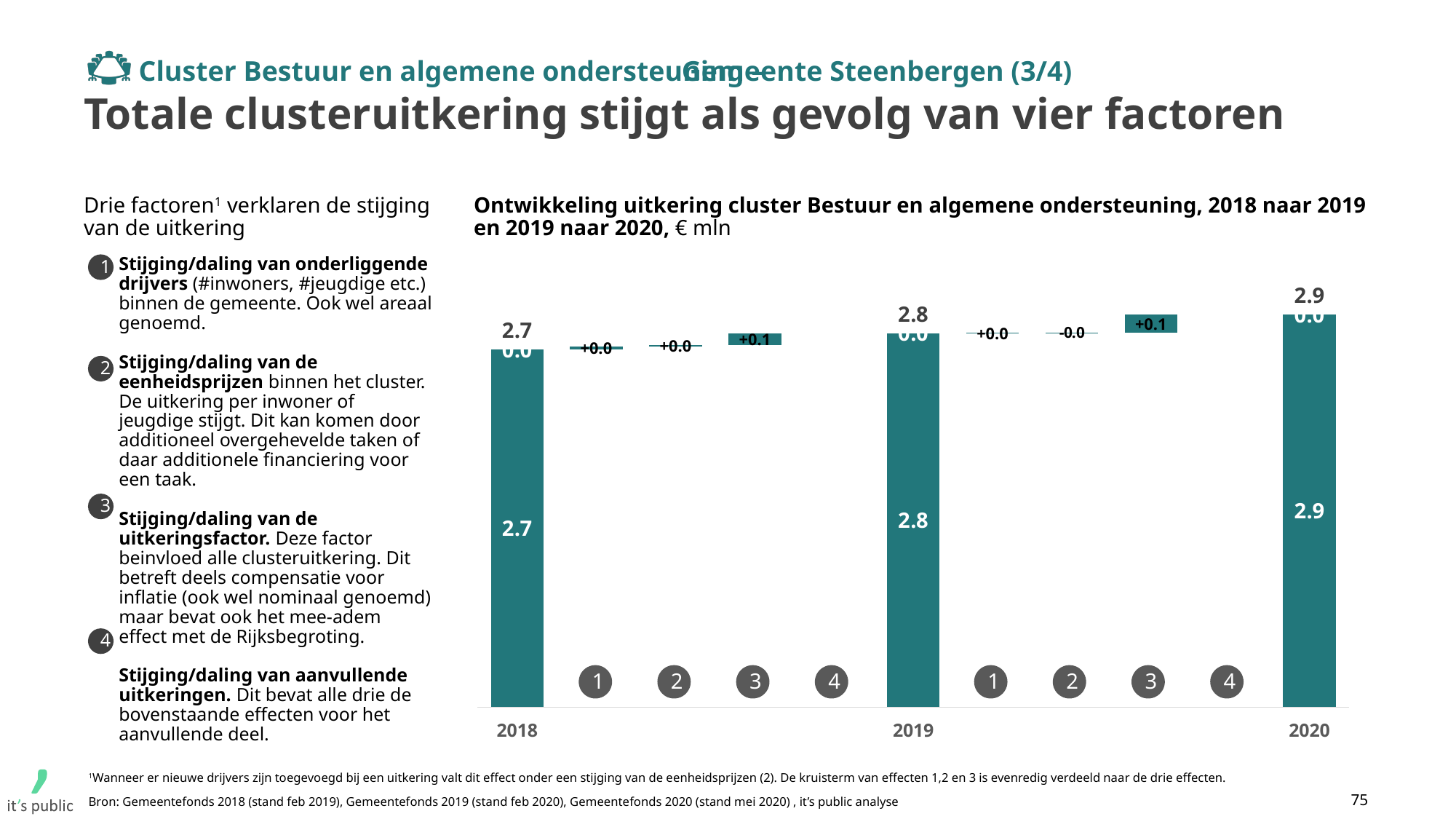
Which is larger, the total for 2019 or the total for 2020? 2020 What is the total uitkering for 2020 shown on the chart? 2.9 Which year has the lowest total uitkering on the chart? 2018 What is the total uitkering for 2018 shown on the chart? 2.7 What is the difference between the 2020 total and the 2018 total? 0.2 In what unit are the values on the chart expressed, according to the chart title? € mln What is the total uitkering for 2019 shown on the chart? 2.8 Which year has the highest total uitkering on the chart? 2020 What is the labelled effect of factor 3 in the step from 2019 to 2020? +0.1 What is the labelled effect of factor 3 in the step from 2018 to 2019? +0.1 Do the yearly totals rise or fall from 2018 to 2020? rise What kind of chart is shown on the slide? bar chart